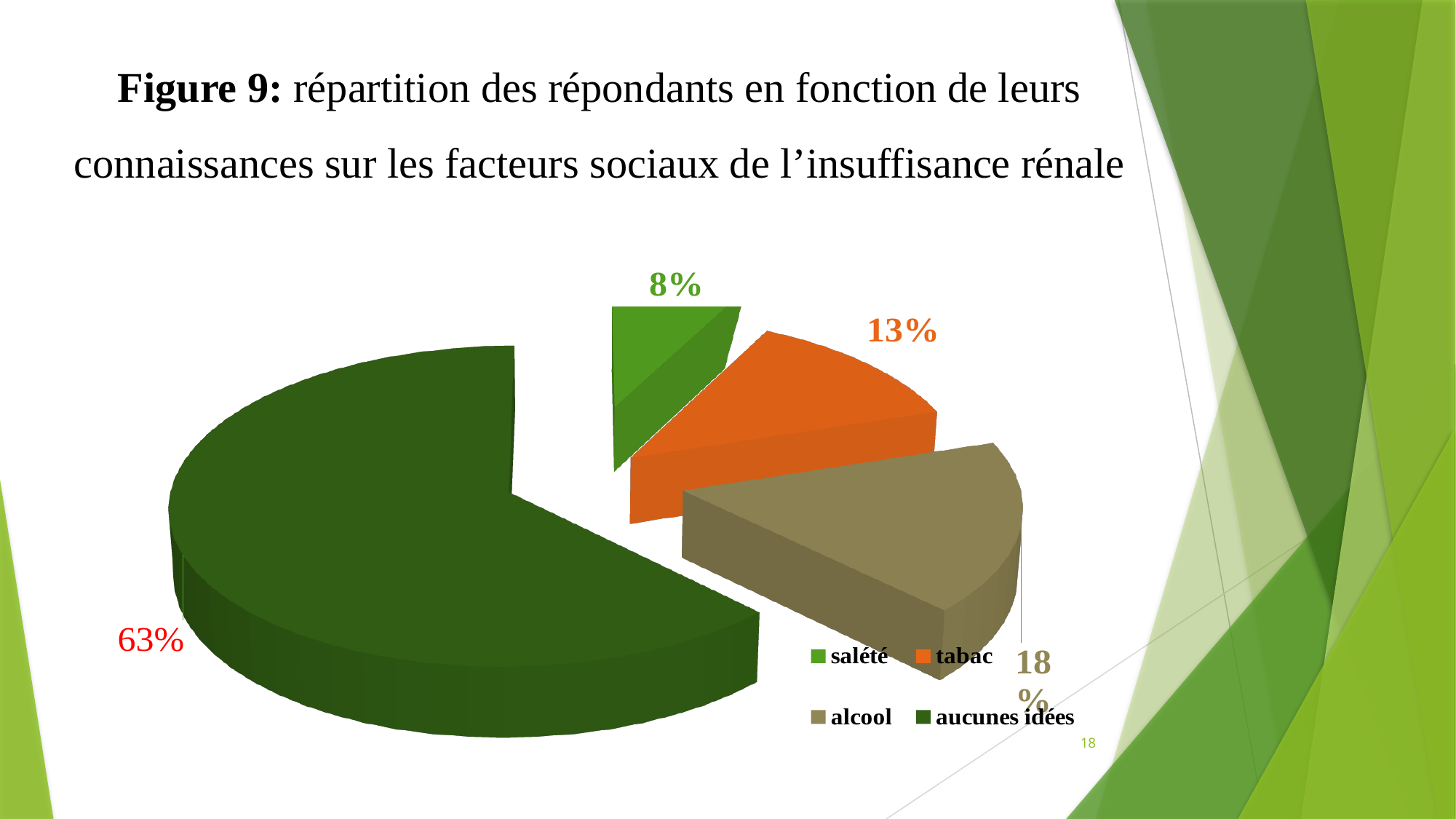
What percentage of respondents is shown for "salété"? 8% What colour is the slice for "tabac"? orange What percentage of respondents is shown for "tabac"? 13% What percentage of respondents is shown for "alcool"? 18% What is the difference in percentage points between "alcool" and "tabac"? 5 How many entries does the legend list? 4 Which is larger, the share for "tabac" or the share for "salété"? tabac What kind of chart is shown on the slide? pie chart How many slices does the pie chart have? 4 Which category has the largest share of the pie? aucunes idées What percentage of respondents is shown for "aucunes idées"? 63% Which category has the smallest share of the pie? salété